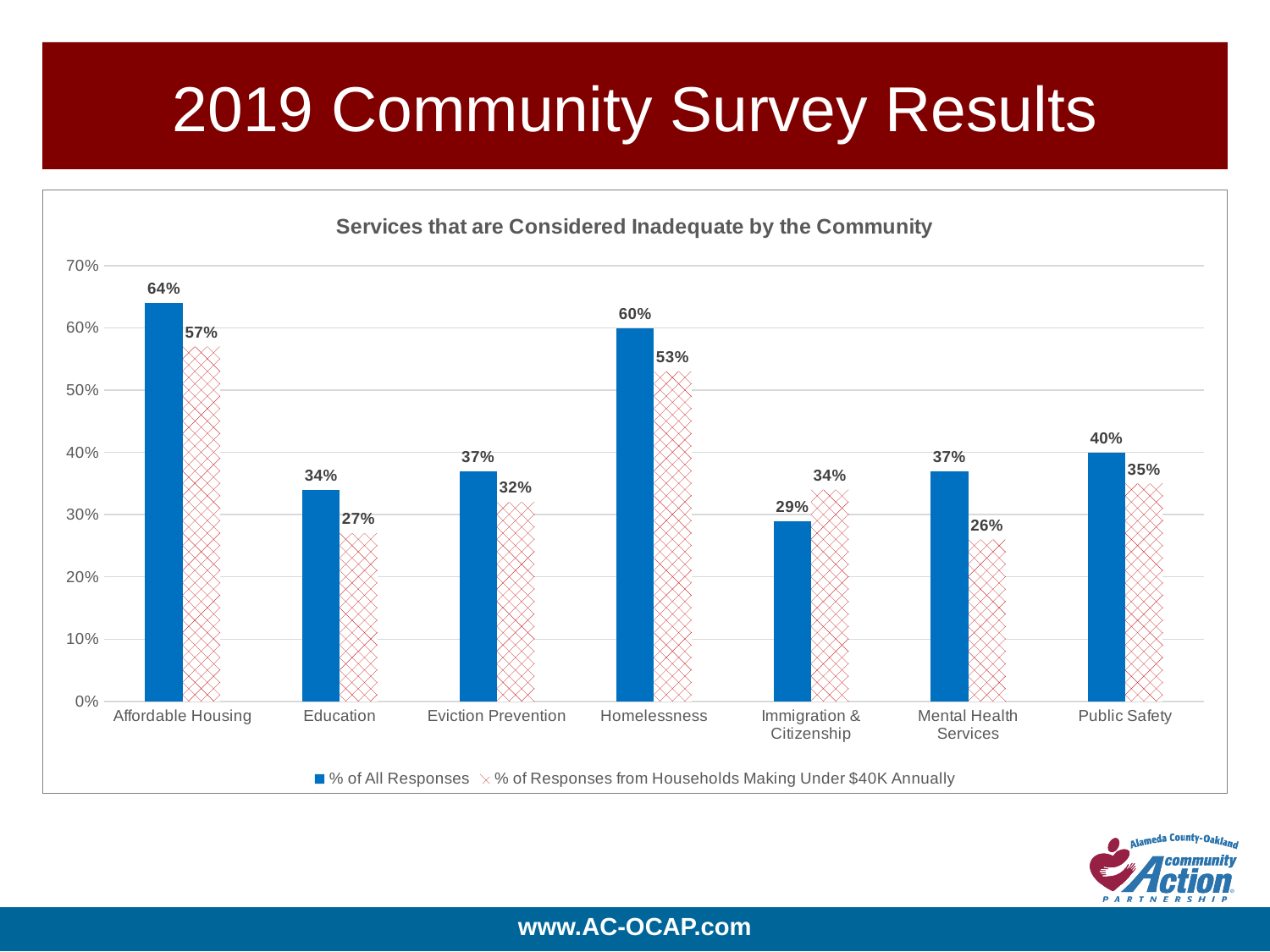
For Immigration & Citizenship, which series has the larger value? % of Responses from Households Making Under $40K Annually What kind of chart is shown on the slide? Bar chart What is the value for Affordable Housing in the % of All Responses series? 64% What is the value for Public Safety in the % of All Responses series? 40% How many series does the legend list? 2 What is the difference between the two series for Mental Health Services? 11% How many categories are shown on the x axis? 7 Which category has the highest value in the % of All Responses series? Affordable Housing Is the value for Homelessness in the % of All Responses series greater or less than 50%? greater What is the title of the chart? Services that are Considered Inadequate by the Community Which category has the lowest value in the % of Responses from Households Making Under $40K Annually series? Mental Health Services What is the value for Immigration & Citizenship in the % of Responses from Households Making Under $40K Annually series? 34%